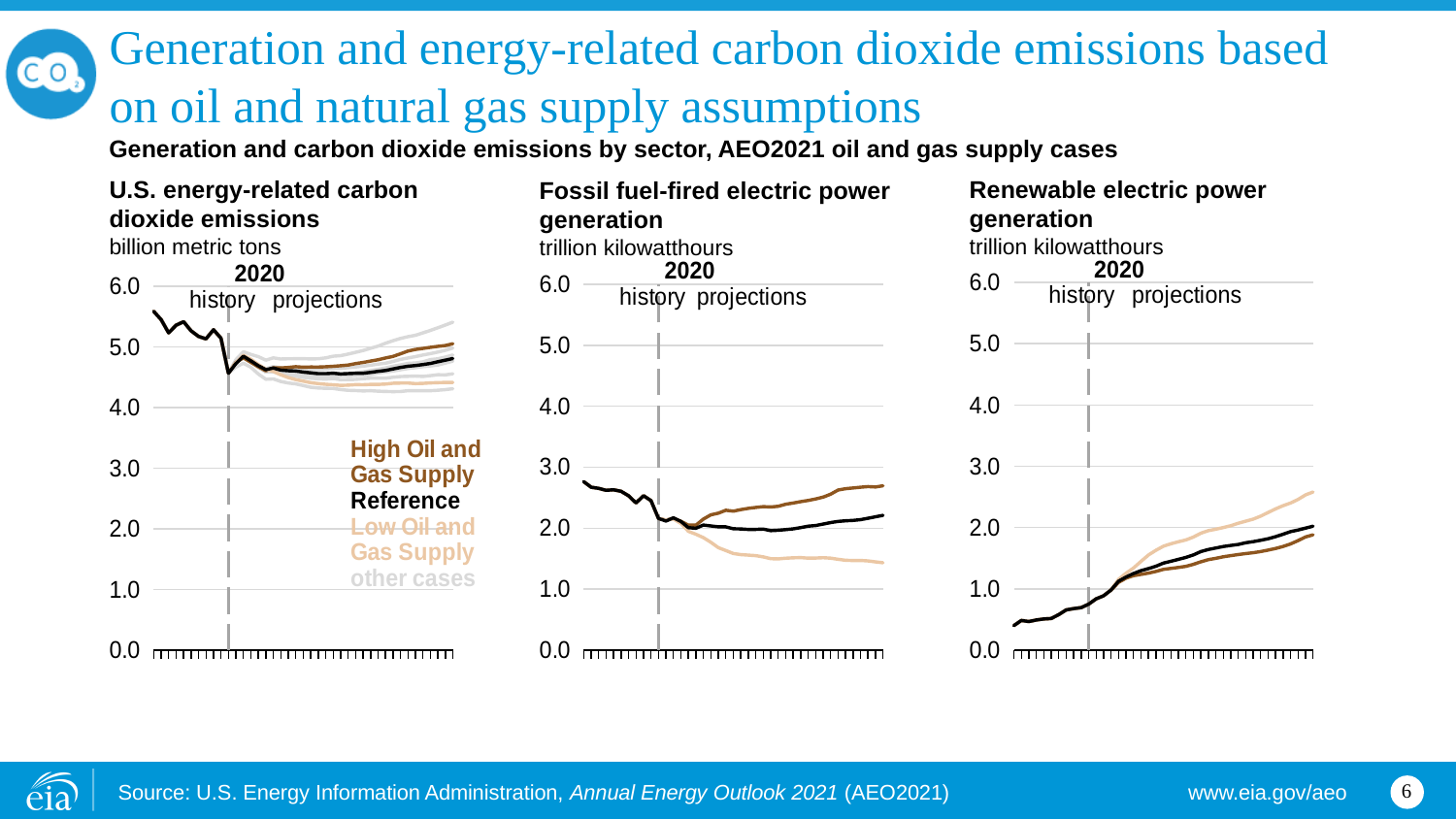
In the "Fossil fuel-fired electric power generation" chart, is the value of the High Oil and Gas Supply line at the end of the projection period greater or less than 2.0? greater In the "Fossil fuel-fired electric power generation" chart, does the Low Oil and Gas Supply line rise or fall over the projection period? fall In the "Fossil fuel-fired electric power generation" chart, is the value of the Low Oil and Gas Supply line at the end of the projection period greater or less than 2.0? less What year does the vertical dashed line separating history from projections mark? 2020 In the "Fossil fuel-fired electric power generation" chart, which line is higher at the end of the projection period, High Oil and Gas Supply or Low Oil and Gas Supply? High Oil and Gas Supply How many charts are shown on the slide? 3 What kind of chart is the "U.S. energy-related carbon dioxide emissions" chart? line chart In the "Renewable electric power generation" chart, is the value of the Low Oil and Gas Supply line at the end of the projection period greater or less than 2.0? greater In the "Renewable electric power generation" chart, do the values rise or fall over time? rise What unit is used on the y axis of the "U.S. energy-related carbon dioxide emissions" chart? billion metric tons